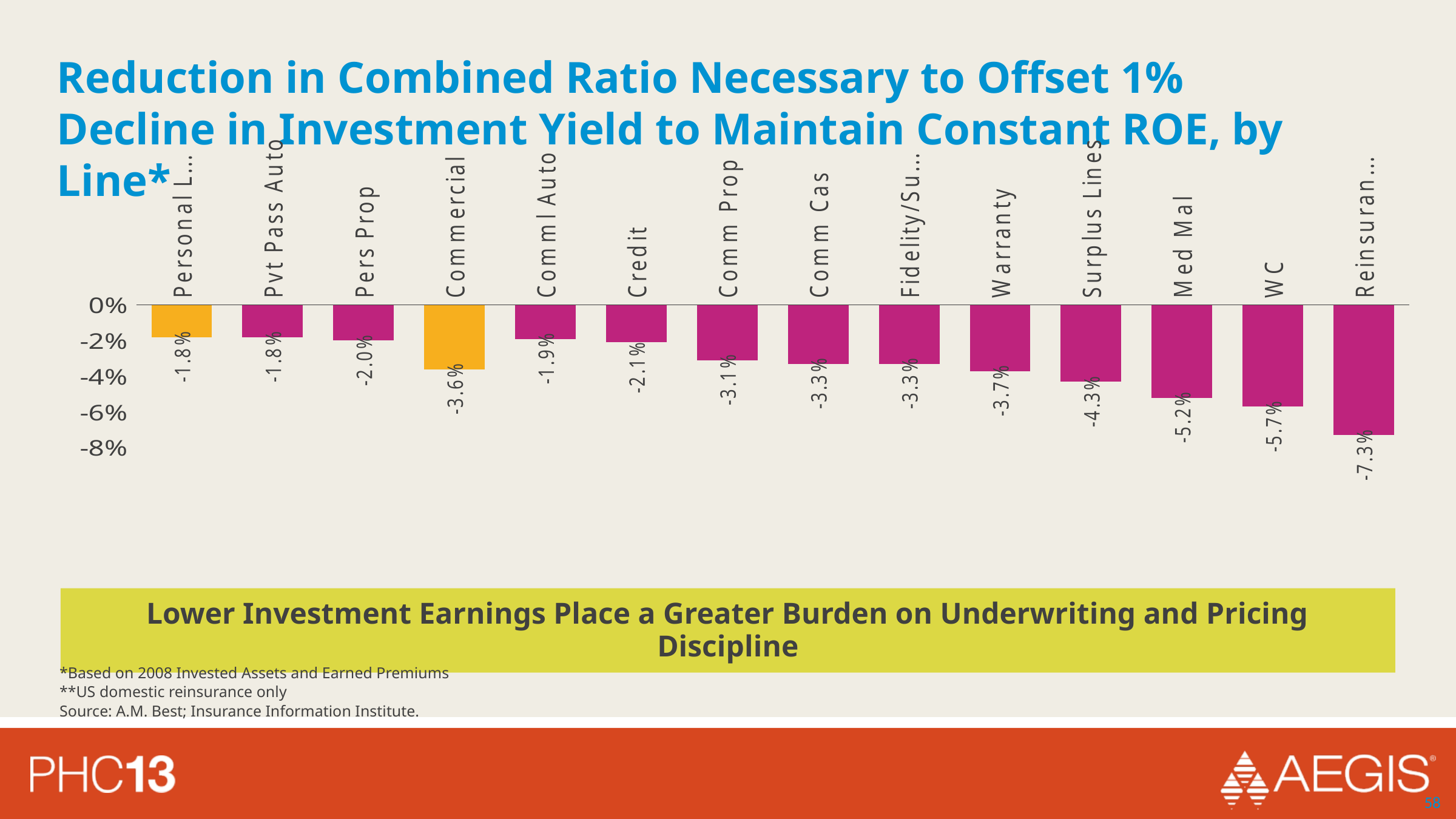
What is the value for Credit? -2.1% What is the value for Med Mal? -5.2% What is the value for WC? -5.7% What is the difference between the values for WC and Med Mal? 0.5% What is the value for Surplus Lines? -4.3% Which two bars are coloured orange rather than magenta? Personal L... and Commercial What is the value for Commercial? -3.6% How many categories are shown in the chart? 14 Which has the larger reduction, Comm Prop or Commercial? Commercial What kind of chart is shown on the slide? Bar chart What is the difference between the values for Warranty and Pers Prop? 1.7% Which has the larger reduction, Surplus Lines or Warranty? Surplus Lines